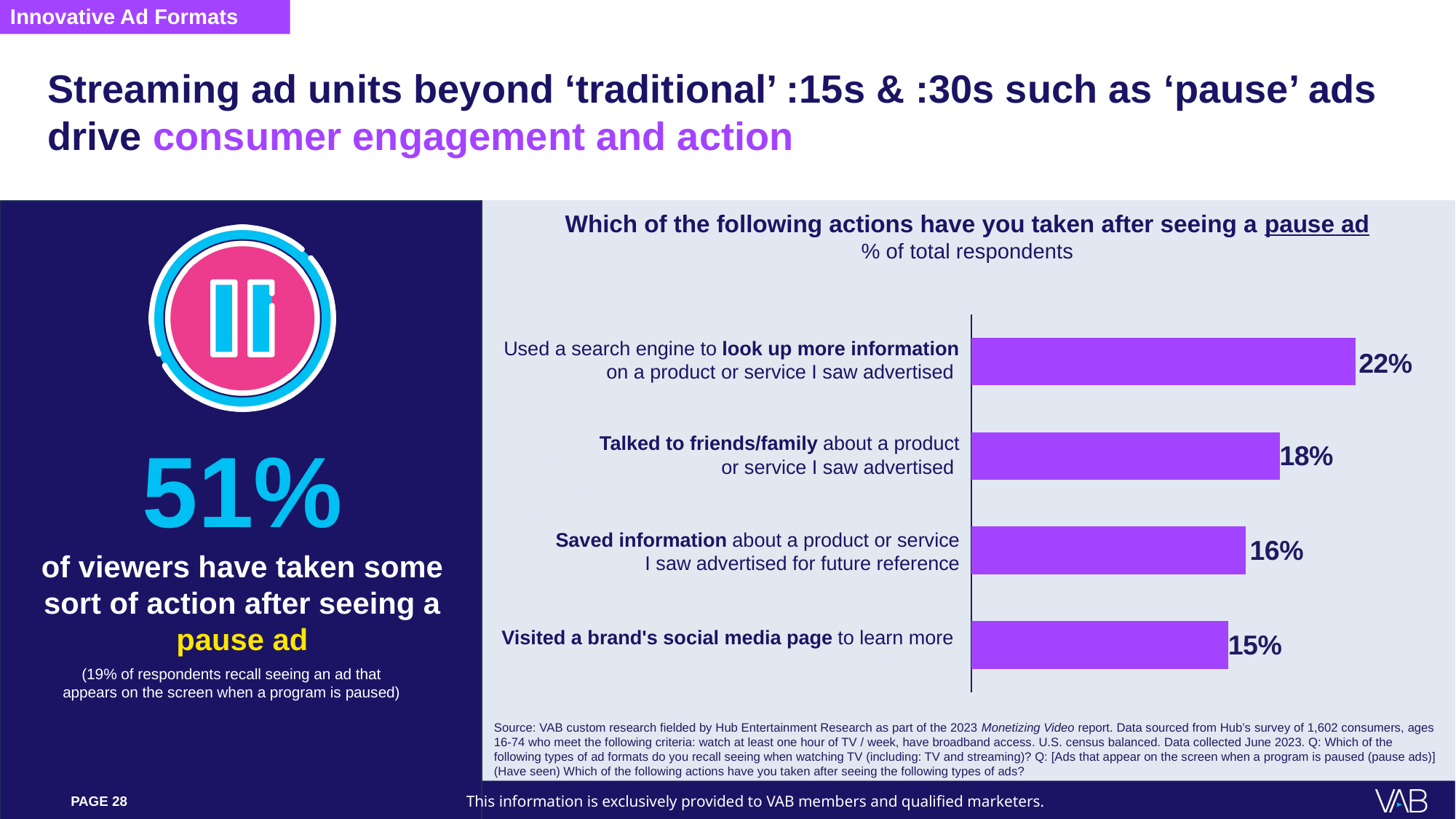
What is the difference in percentage points between using a search engine to look up more information and visiting a brand's social media page? 7 What type of chart is used to show the actions taken after seeing a pause ad? Bar chart Which action has the lowest percentage of respondents? Visited a brand's social media page to learn more What colour are the bars in the chart? Purple What percentage of respondents visited a brand's social media page to learn more? 15% Which is larger: the share who talked to friends/family or the share who saved information for future reference? Talked to friends/family How many actions are shown in the chart? 4 What is the title of the chart? Which of the following actions have you taken after seeing a pause ad Which action has the highest percentage of respondents? Used a search engine to look up more information on a product or service I saw advertised What percentage of respondents saved information about a product or service for future reference? 16% What percentage of respondents talked to friends/family about a product or service they saw advertised? 18% What percentage of respondents used a search engine to look up more information on a product or service they saw advertised after seeing a pause ad? 22%